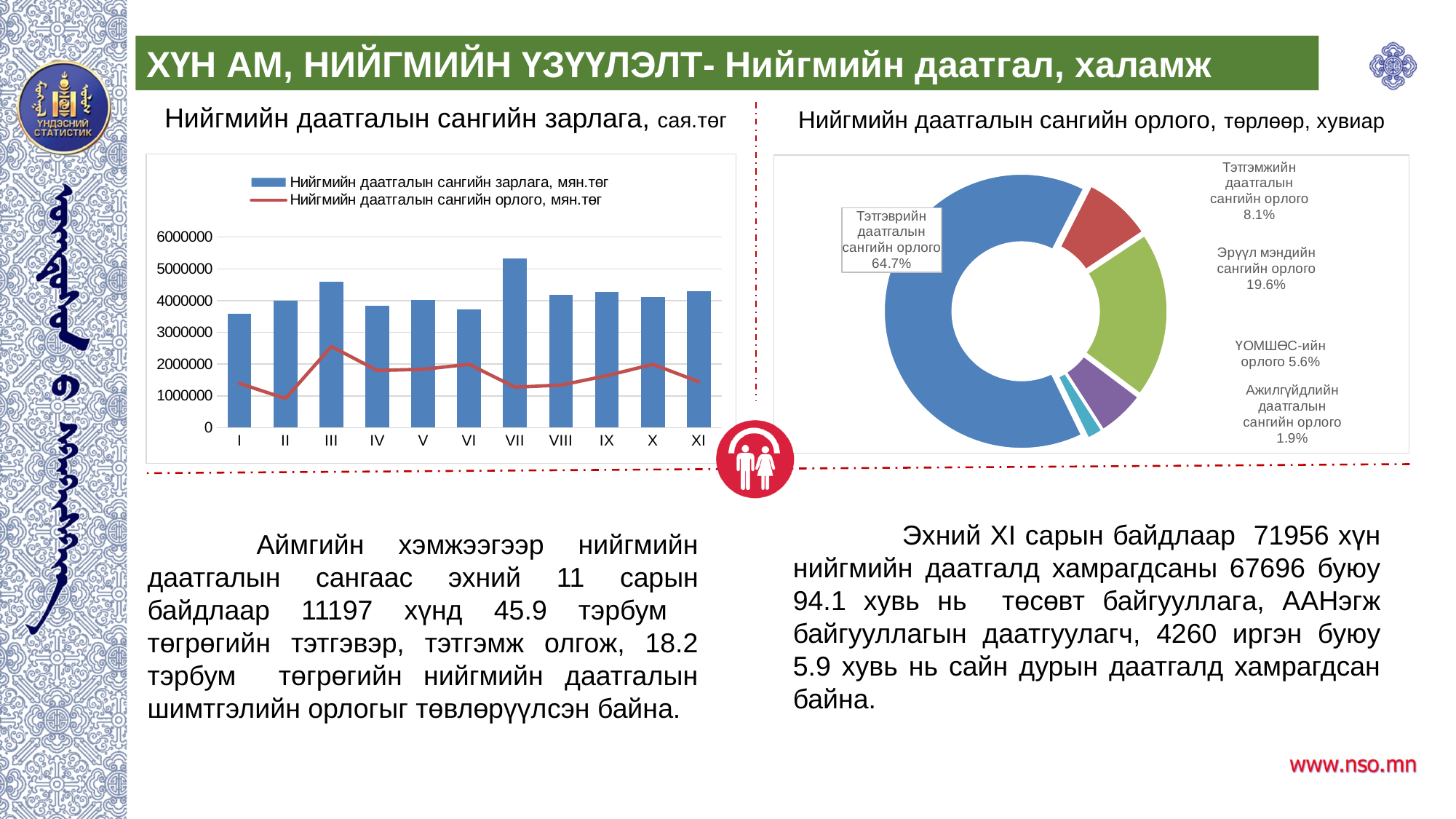
What kind of chart is the right chart titled 'Нийгмийн даатгалын сангийн орлого, төрлөөр, хувиар'? Doughnut (pie) chart What kind of chart is the left chart titled 'Нийгмийн даатгалын сангийн зарлага'? Bar chart with a line In the right chart, what share does 'Тэтгэврийн даатгалын сангийн орлого' have? 64.7% In the left chart, is the line value ('Нийгмийн даатгалын сангийн орлого') for month II greater or less than 1000000? less In the left chart, which month has the lowest bar for 'Нийгмийн даатгалын сангийн зарлага'? I In the right chart, what is the difference between the shares of 'Эрүүл мэндийн сангийн орлого' and 'Тэтгэмжийн даатгалын сангийн орлого'? 11.5% In the left chart, is the bar value for month VII greater or less than 5000000? greater In the left chart, which month has the highest bar for 'Нийгмийн даатгалын сангийн зарлага'? VII How many series does the legend of the left chart list? 2 How many months (categories) are shown on the x axis of the left chart? 11 In the left chart, which month has the highest value on the line series 'Нийгмийн даатгалын сангийн орлого'? III In the right chart, which category has the smallest share? Ажилгүйдлийн даатгалын сангийн орлого